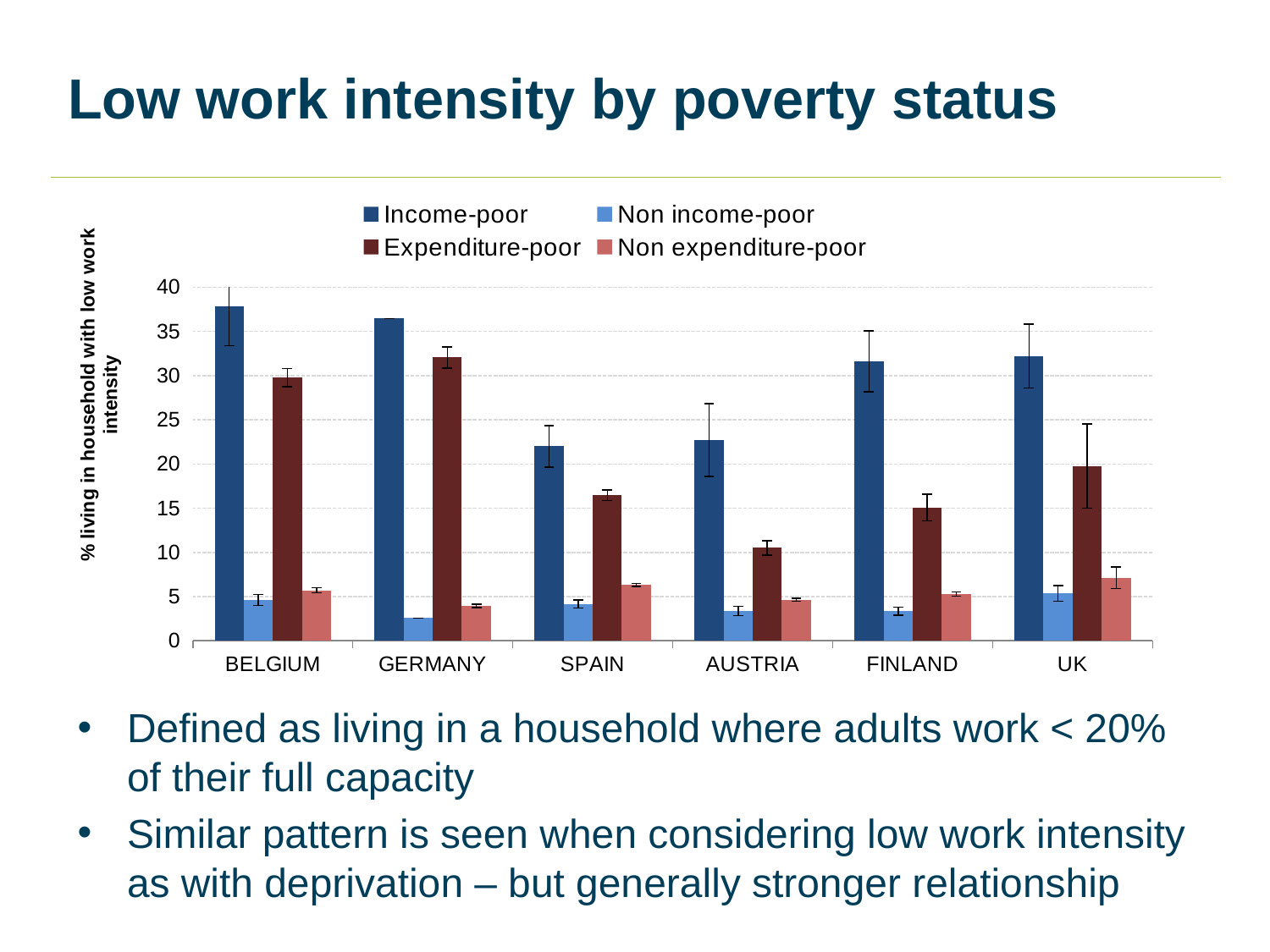
Which country has the highest Expenditure-poor value? GERMANY Is the Income-poor value for FINLAND greater or less than 30? greater Is the Income-poor value for BELGIUM greater or less than 35? greater What kind of chart is shown on the slide? bar chart Is the Non income-poor value for GERMANY greater or less than 5? less Which country has the lowest Non income-poor value? GERMANY How many countries are shown on the x axis of the chart? 6 Which is larger: the Expenditure-poor value for FINLAND or for the UK? UK Which country has the lowest Expenditure-poor value? AUSTRIA How many series does the chart's legend list? 4 For BELGIUM, which is larger: the Income-poor value or the Expenditure-poor value? Income-poor